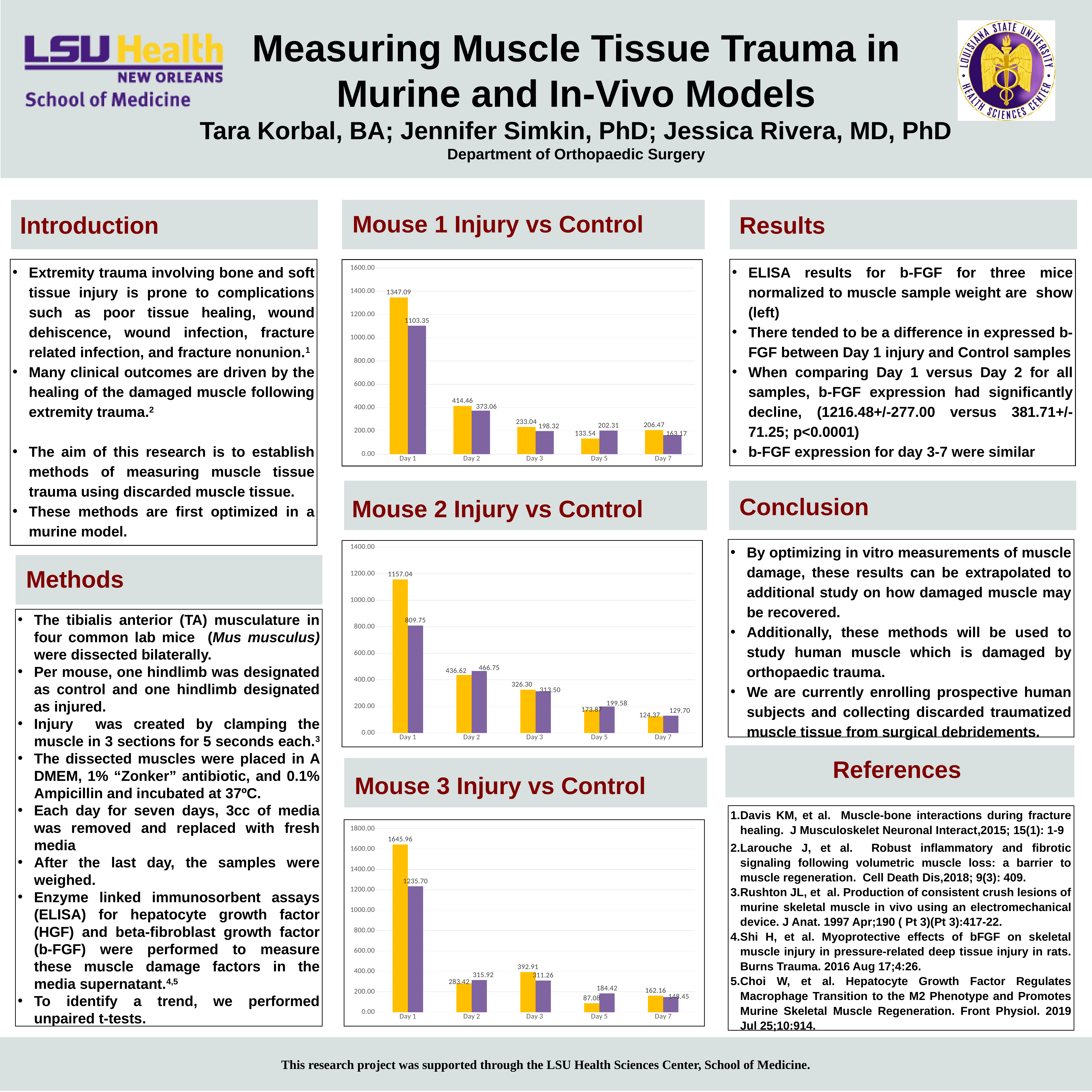
In the Mouse 3 Injury vs Control chart, which day has the lowest yellow bar? Day 5 What kind of chart is the Mouse 2 Injury vs Control chart? bar chart In the Mouse 1 Injury vs Control chart, which day has the highest yellow bar? Day 1 In the Mouse 2 Injury vs Control chart, do the yellow bars rise or fall from Day 1 to Day 7? fall In the Mouse 3 Injury vs Control chart, what is the value of the yellow bar for Day 5? 87.08 In the Mouse 1 Injury vs Control chart, which bar is larger for Day 5, the yellow or the purple? purple In the Mouse 1 Injury vs Control chart, what is the value of the yellow bar for Day 1? 1347.09 In the Mouse 2 Injury vs Control chart, what is the difference between the yellow and purple bars for Day 1? 347.29 How many day categories are shown on the x axis of the Mouse 1 Injury vs Control chart? 5 In the Mouse 3 Injury vs Control chart, what is the difference between the yellow bars for Day 1 and Day 2? 1362.54 In the Mouse 3 Injury vs Control chart, which bar is larger for Day 1, the yellow or the purple? yellow In the Mouse 2 Injury vs Control chart, what is the value of the purple bar for Day 3? 313.50